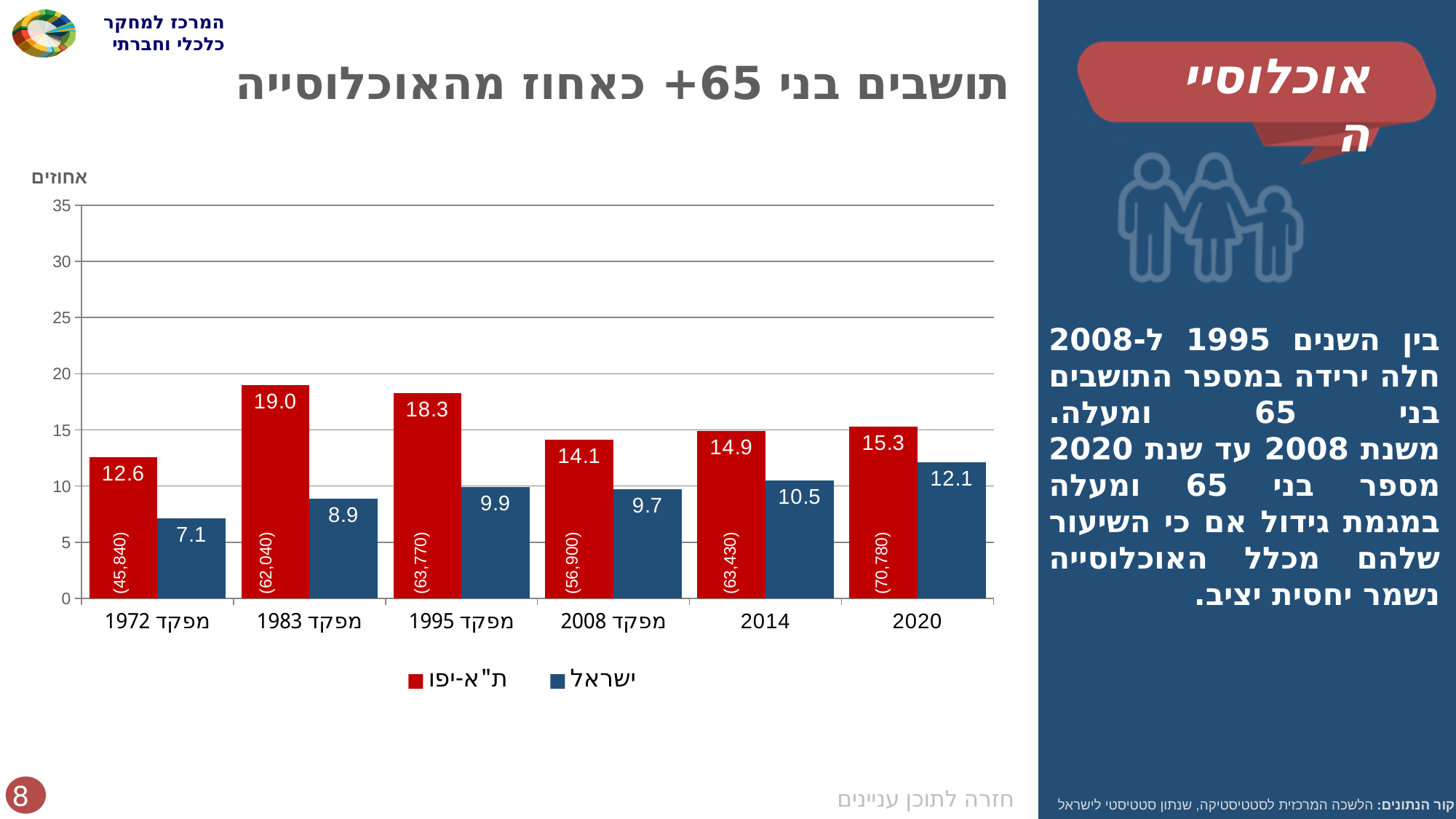
How many categories are shown on the x axis? 6 What is the difference between the ת"א-יפו and ישראל values in מפקד 1995? 8.4 What kind of chart is shown on the slide? bar chart In which category is the ישראל value lowest? מפקד 1972 What absolute number is printed inside the ת"א-יפו bar for 2020? (70,780) What is the value for ישראל in מפקד 1972? 7.1 In which category is the ת"א-יפו value highest? מפקד 1983 How many series does the legend list? 2 Which colour represents the ישראל series? blue Which is larger: the ת"א-יפו value in 2014 or in 2020? 2020 What is the value for ת"א-יפו in מפקד 1983? 19.0 What is the value for ישראל in 2020? 12.1